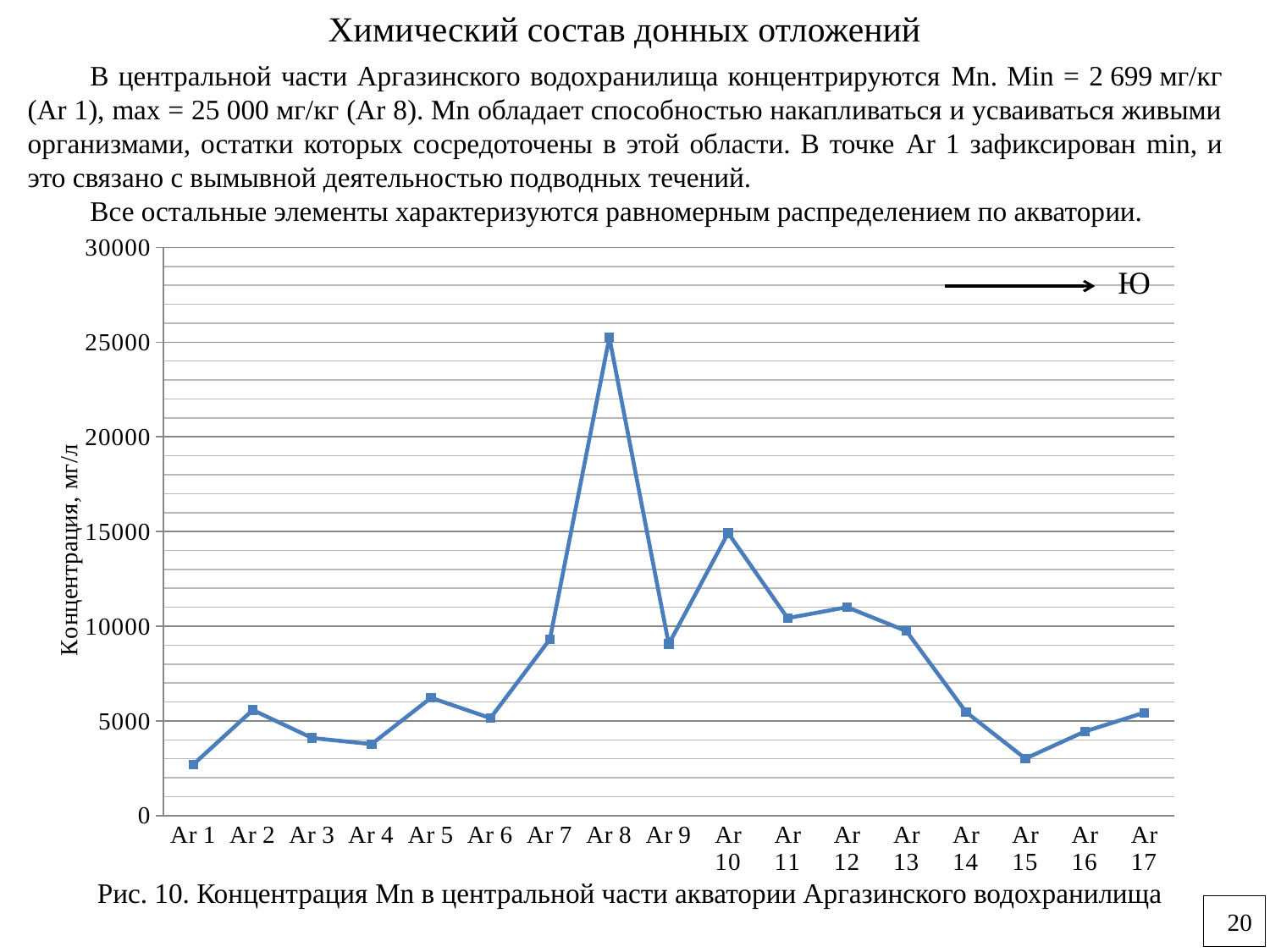
What kind of chart is shown on the slide? line chart Is the value for Ar 1 greater or less than 5000? less Is the value for Ar 12 greater or less than 10000? greater Which has the larger value, Ar 8 or Ar 10? Ar 8 Is the value for Ar 15 greater or less than 5000? less Which has the larger value, Ar 2 or Ar 3? Ar 2 At which sampling point is the Mn concentration highest? Ar 8 At which sampling point is the Mn concentration lowest? Ar 1 How many sampling points (categories) are plotted along the x axis? 17 Does the value rise or fall from Ar 13 to Ar 15? fall